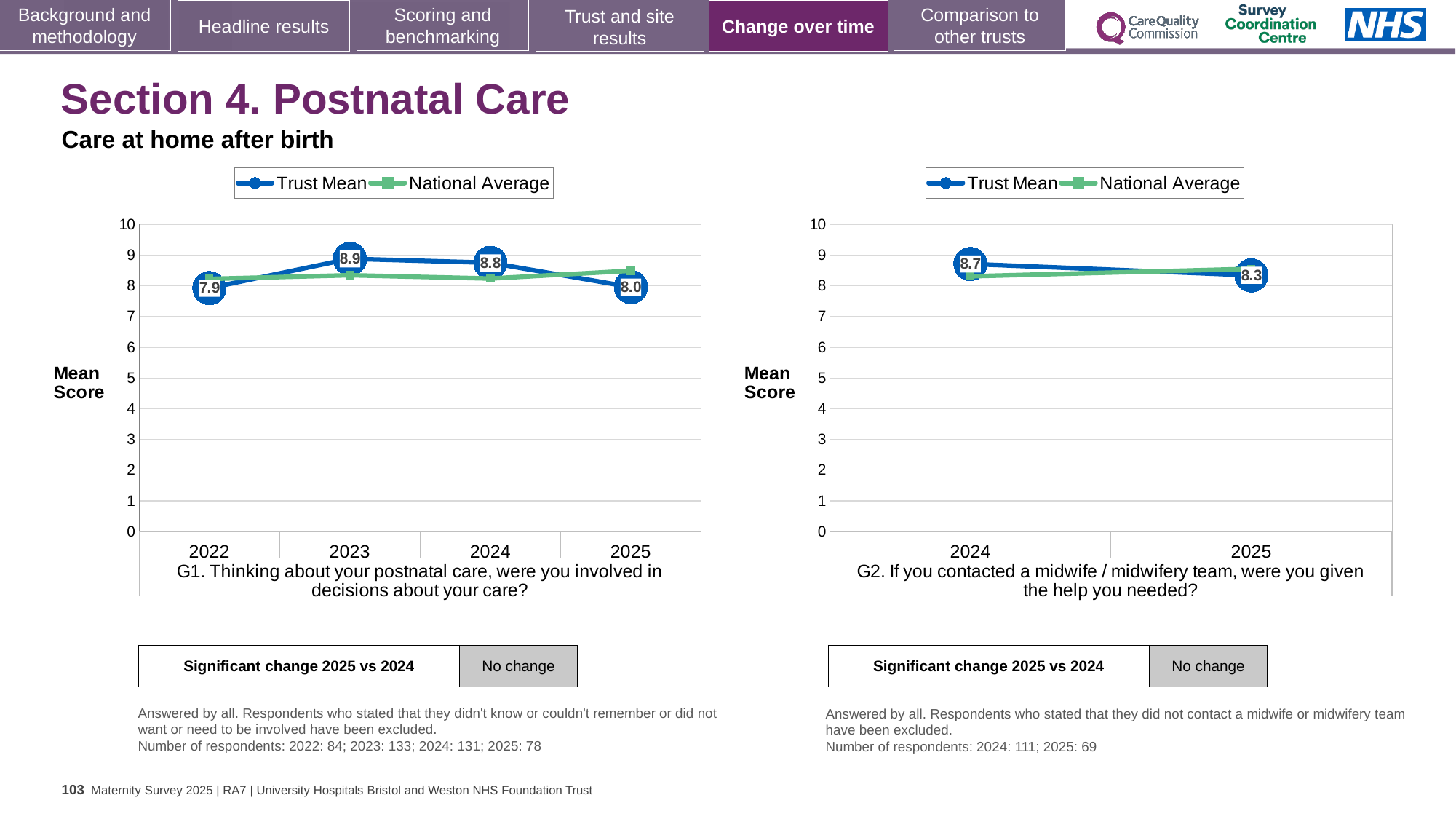
In the G2 chart on the right, what is the difference between the Trust Mean for 2024 and 2025? 0.4 In the G1 chart on the left, which year has the lowest Trust Mean? 2022 In the G2 chart on the right, does the Trust Mean rise or fall from 2024 to 2025? fall In the G1 chart on the left, what is the Trust Mean for 2022? 7.9 In the G2 chart on the right, how many series does the legend list? 2 In the G1 chart on the left, what is the Trust Mean for 2023? 8.9 In the G1 chart on the left, is the Trust Mean higher in 2024 or in 2025? 2024 In the G2 chart on the right, what is the Trust Mean for 2025? 8.3 In the G1 chart on the left, which year has the highest Trust Mean? 2023 In the G2 chart on the right, what is the Trust Mean for 2024? 8.7 In the G1 chart on the left, how many years are plotted on the x axis? 4 In the G1 chart on the left, what is the Trust Mean for 2025? 8.0